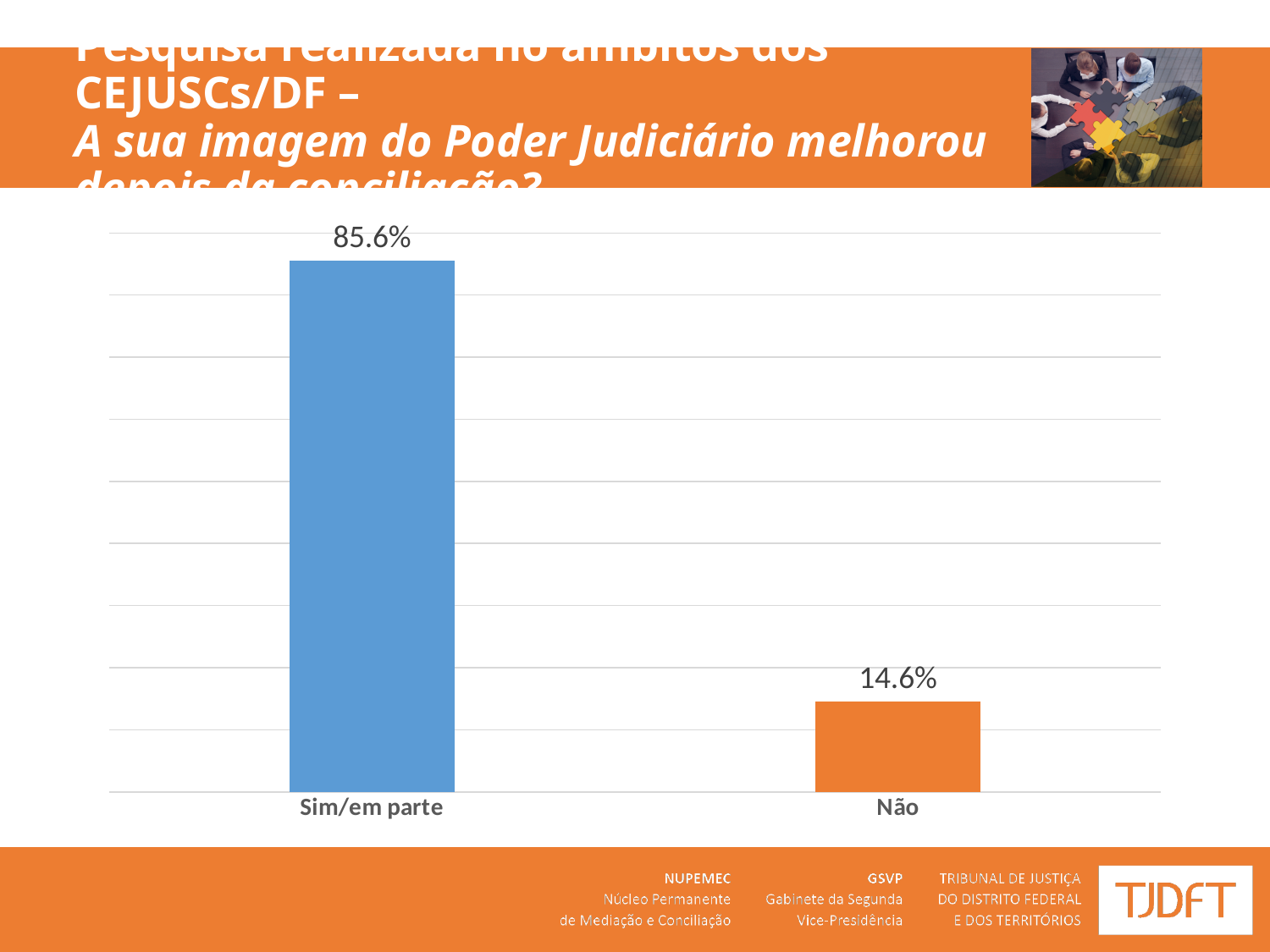
What is the value for "Não"? 14.6% Which category has the highest value? Sim/em parte Which category has the lowest value? Não How many categories are shown on the chart? 2 What kind of chart is shown on the slide? Bar chart What is the value for "Sim/em parte"? 85.6% What colour is the bar for "Não"? Orange Which is larger, the value for "Sim/em parte" or the value for "Não"? Sim/em parte What colour is the bar for "Sim/em parte"? Blue What is the difference between the values for "Sim/em parte" and "Não"? 71.0%